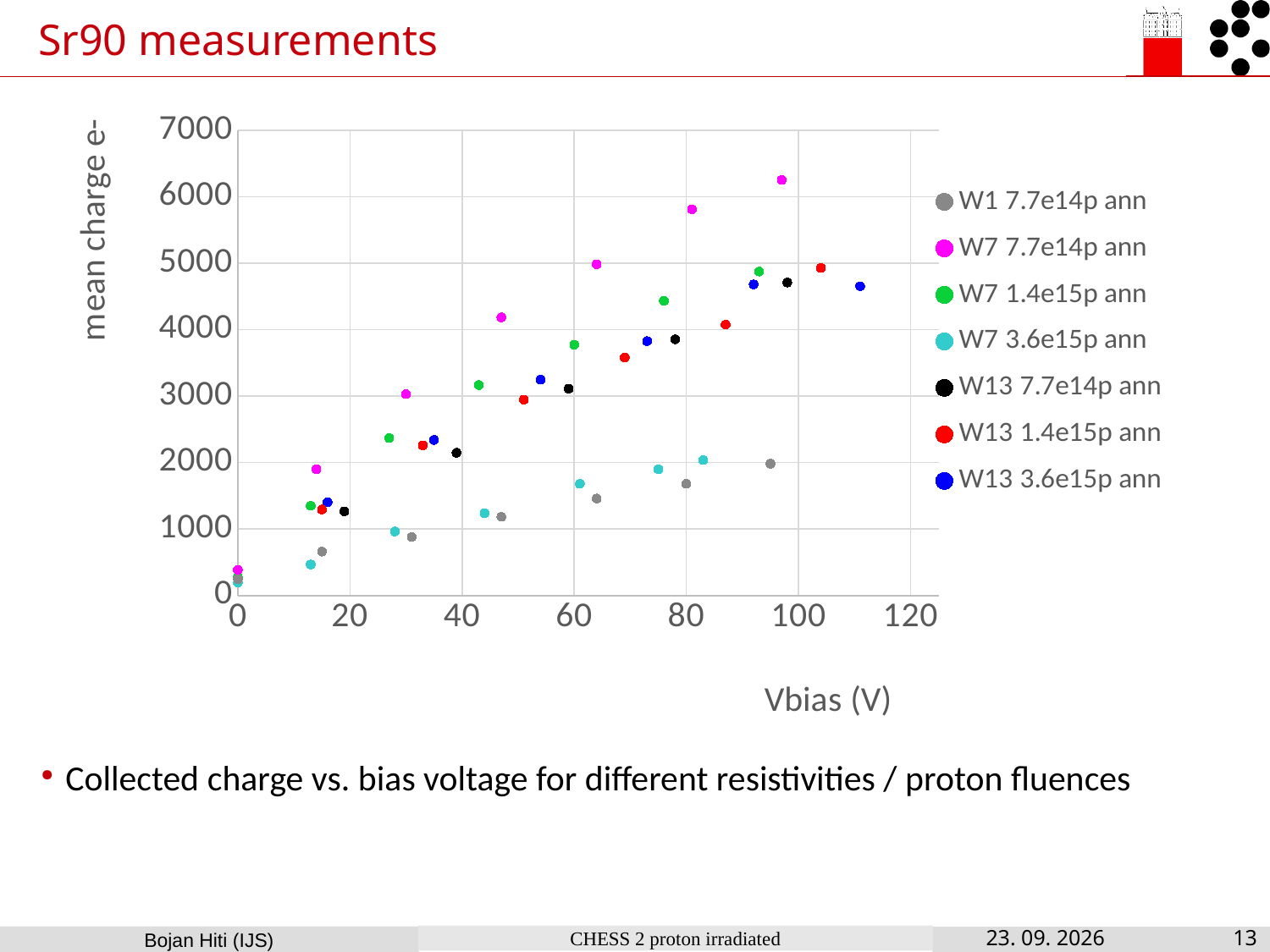
How many series does the legend list? 7 Which series reaches the highest mean charge on the chart? W7 7.7e14p ann Is the highest value for W7 7.7e14p ann greater or less than 6000? greater Do the mean charge values rise or fall as Vbias increases? rise At around 60 V, which series has the larger mean charge: W7 7.7e14p ann or W1 7.7e14p ann? W7 7.7e14p ann What is the label of the y axis? mean charge e- What is the label of the x axis? Vbias (V) Is the highest value for W7 3.6e15p ann greater or less than 3000? less Is the highest value for W13 1.4e15p ann greater or less than 4000? greater What kind of chart is shown on the slide? scatter chart At around 100 V, which series has the larger mean charge: W13 1.4e15p ann or W1 7.7e14p ann? W13 1.4e15p ann